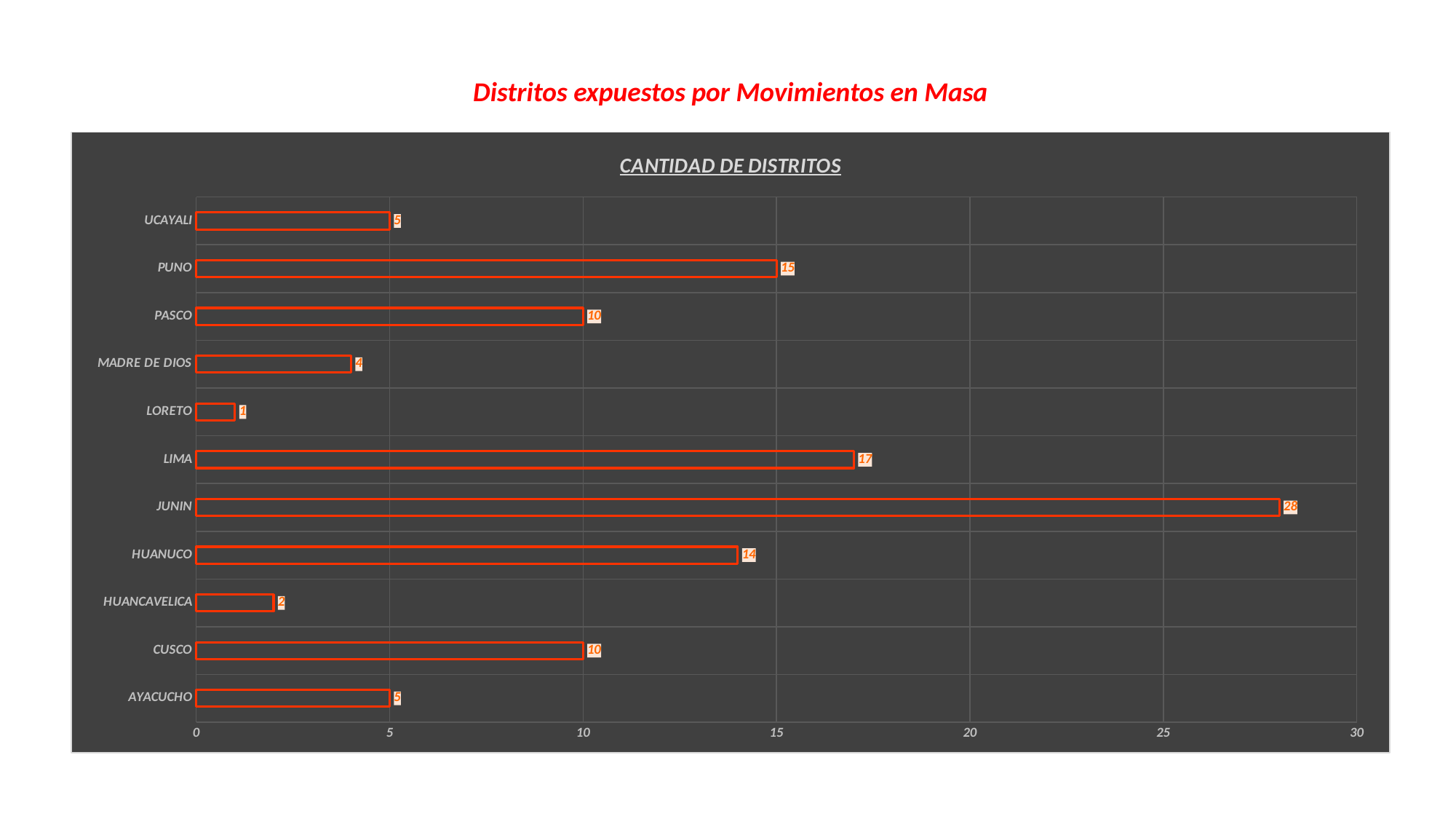
What is the value for LIMA? 17 What is the difference between the values for JUNIN and LIMA? 11 Which is larger, the value for PUNO or the value for PASCO? PUNO Is the value for HUANUCO greater or less than 10? greater What is the value for JUNIN? 28 Which category has the lowest value? LORETO Which category has the highest value? JUNIN What kind of chart is shown? bar chart What is the title shown inside the chart area? CANTIDAD DE DISTRITOS How many categories are shown in the chart? 11 What is the value for MADRE DE DIOS? 4 What is the difference between the values for PUNO and HUANUCO? 1